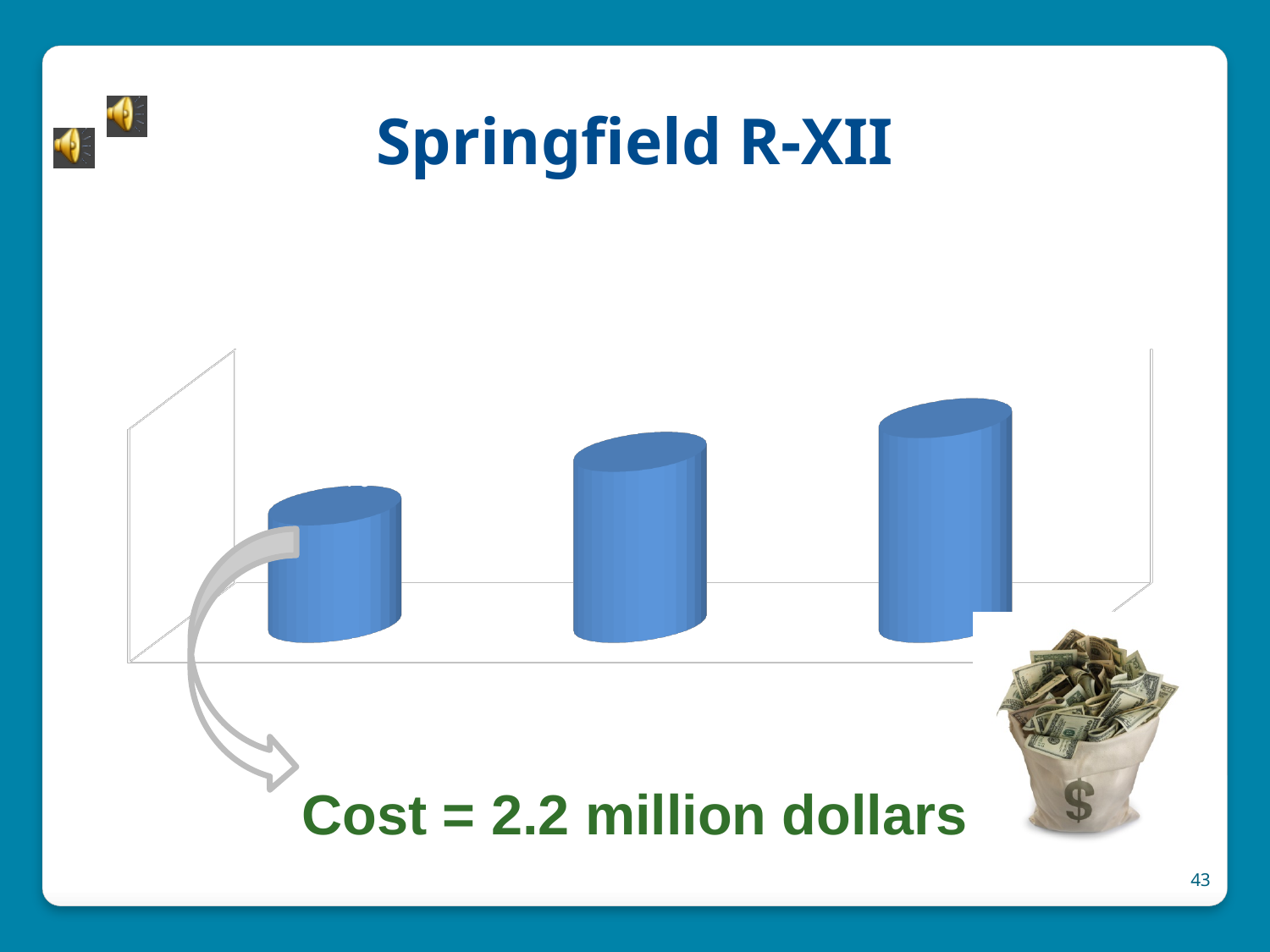
Which is larger, the middle bar or the leftmost bar? the middle bar What is the title of the slide containing the chart? Springfield R-XII Which bar is the shortest in the chart? the leftmost (first) bar Which is larger, the leftmost bar or the rightmost bar? the rightmost bar Which bar is the tallest in the chart? the rightmost (third) bar Do the bar values rise or fall from left to right across the chart? rise What kind of chart is shown on the slide? bar chart What cost is annotated with an arrow pointing to the leftmost bar? Cost = 2.2 million dollars How many bars are plotted in the chart? 3